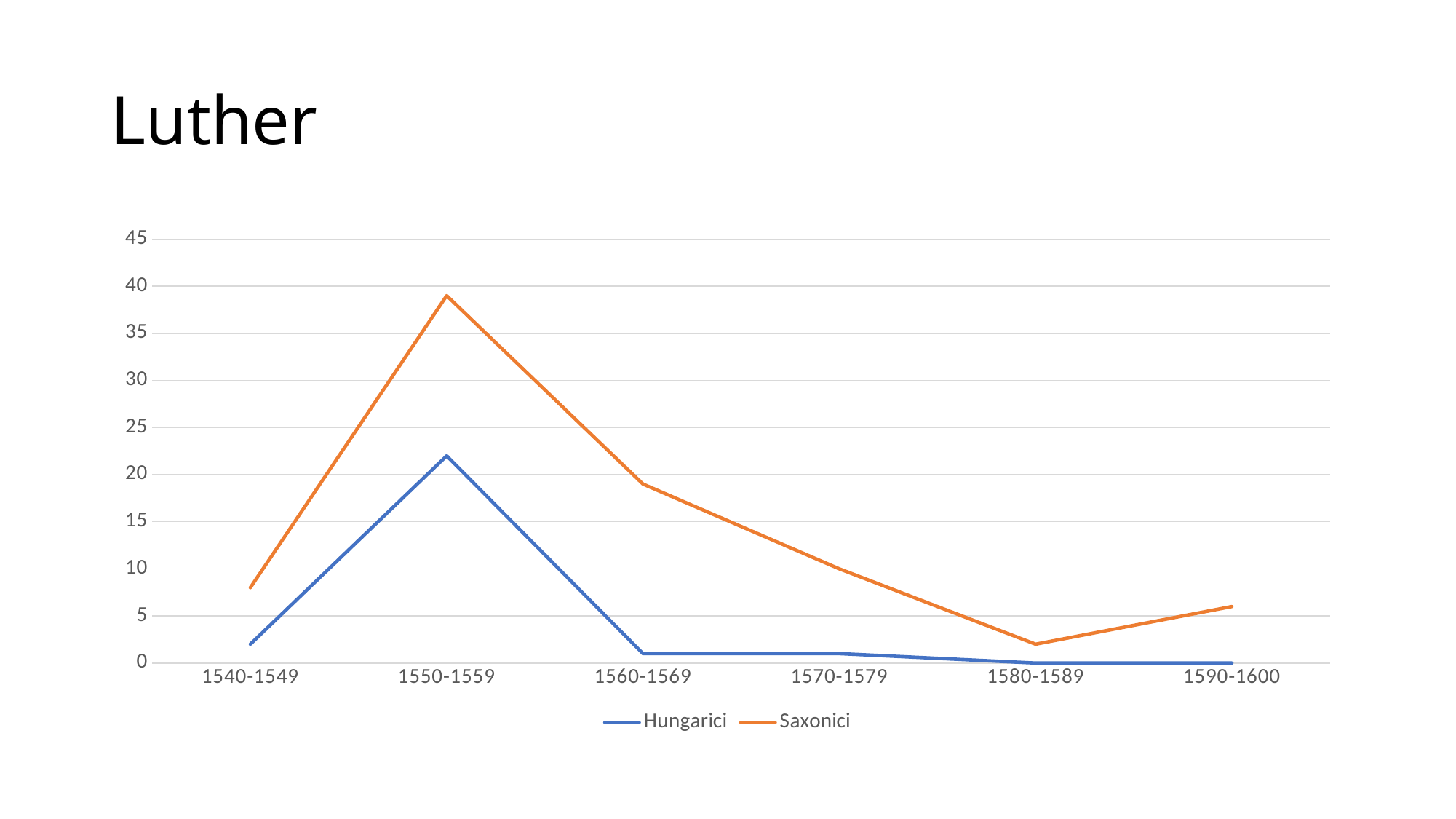
Is the value for Saxonici in 1550-1559 greater or less than 35? greater Is the value for Saxonici in 1580-1589 greater or less than 5? less Is the value for Hungarici in 1550-1559 greater or less than 20? greater How many series does the legend list? 2 Which series has the larger value in 1560-1569, Hungarici or Saxonici? Saxonici What is the title of the slide containing the chart? Luther In which period does the Hungarici series reach its highest value? 1550-1559 Does the Saxonici series rise or fall from 1550-1559 to 1580-1589? fall What kind of chart is shown on the slide? line chart How many time periods are shown on the x axis? 6 In which period does the Saxonici series reach its highest value? 1550-1559